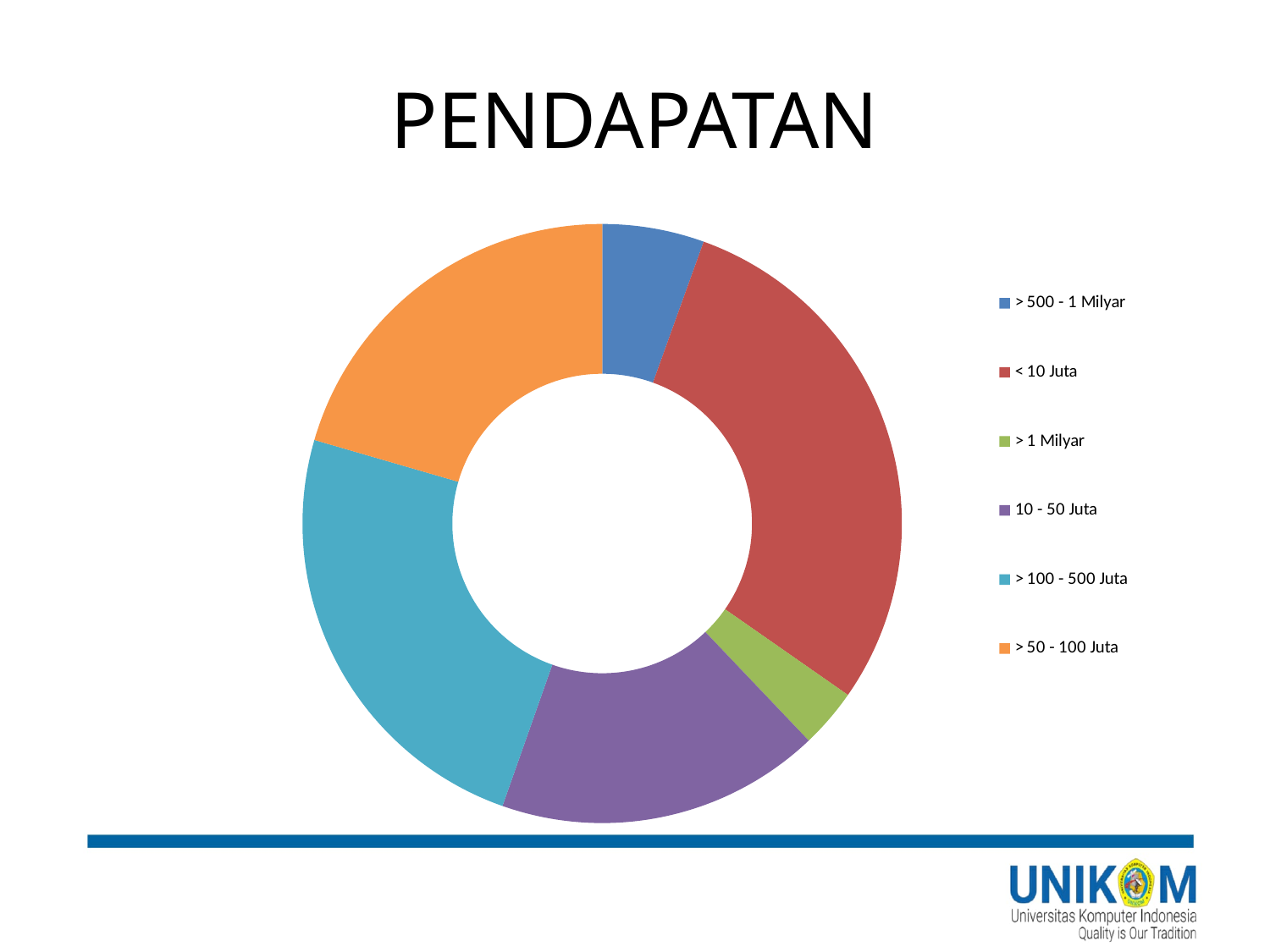
Which slice is larger: "> 1 Milyar" or "10 - 50 Juta"? 10 - 50 Juta Which slice is larger: "> 100 - 500 Juta" or "> 50 - 100 Juta"? > 100 - 500 Juta Which slice is larger: "> 100 - 500 Juta" or "10 - 50 Juta"? > 100 - 500 Juta What colour represents the "< 10 Juta" category in the chart? Red Which category has the largest slice of the chart? < 10 Juta How many categories does the chart's legend list? 6 What is the title of the chart on the slide? PENDAPATAN Which category has the smallest slice of the chart? > 1 Milyar What kind of chart is shown on the slide? Doughnut (pie) chart